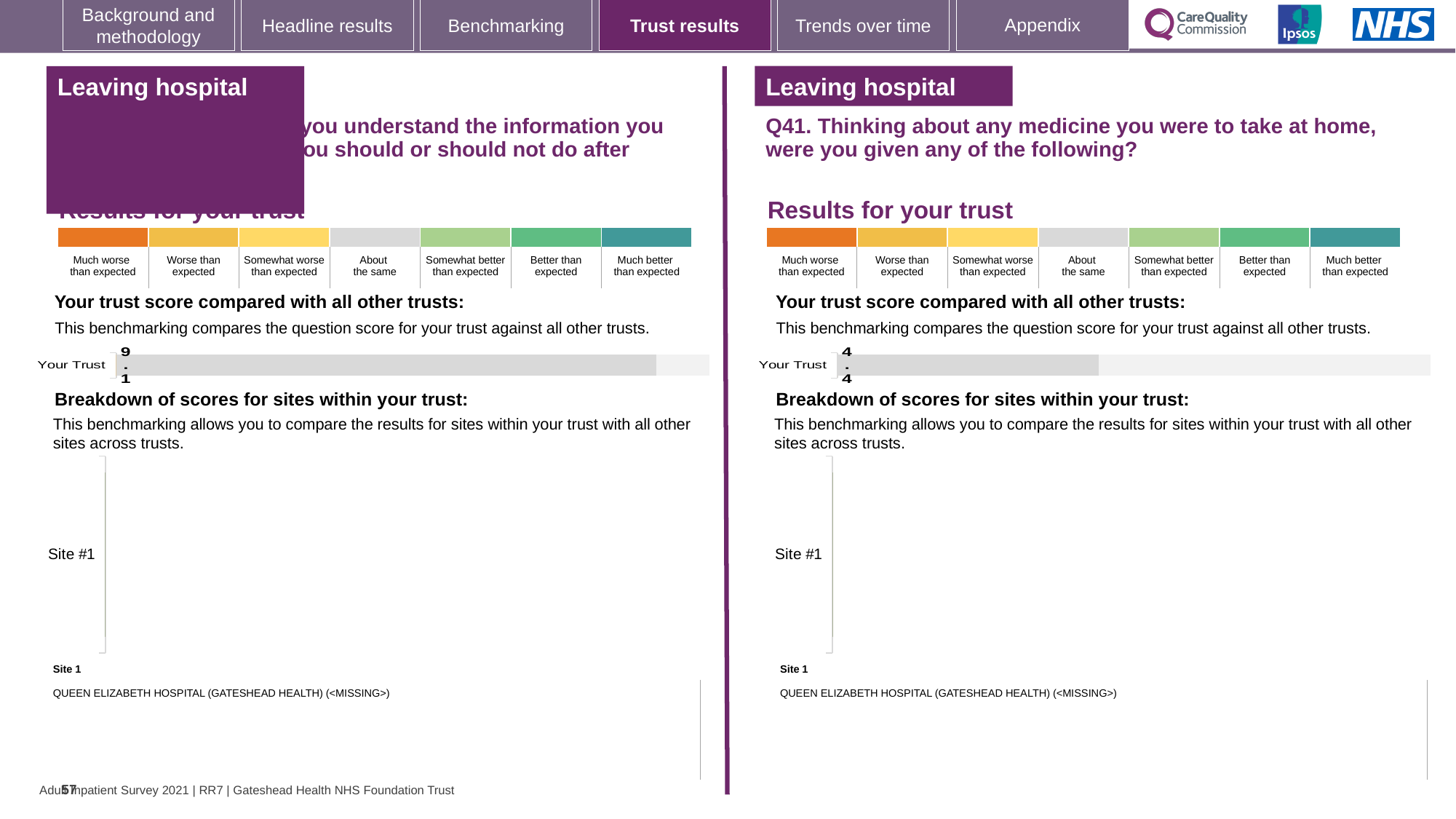
How many bars are plotted in the Your Trust chart on the left-hand panel? 1 On the right-hand panel (Q41), what colour represents 'Much worse than expected' in the colour scale? orange On the left-hand chart, what is the score shown for Your Trust? 9.1 How many sites are listed in the 'Breakdown of scores for sites within your trust' chart on the right-hand panel (Q41)? 1 What is the difference between the Your Trust score on the left-hand chart and the Your Trust score on the right-hand chart (Q41)? 4.7 On the right-hand chart (Q41), what is the score shown for Your Trust? 4.4 What kind of chart is used to show the Your Trust score on the right-hand panel (Q41)? bar chart How many categories does the colour scale above the 'Your trust score compared with all other trusts' chart on the right-hand panel (Q41) contain? 7 Which panel shows the higher Your Trust score, the left-hand chart or the right-hand chart (Q41)? the left-hand chart What is the label of the only site in the site breakdown chart on the left-hand panel? Site #1